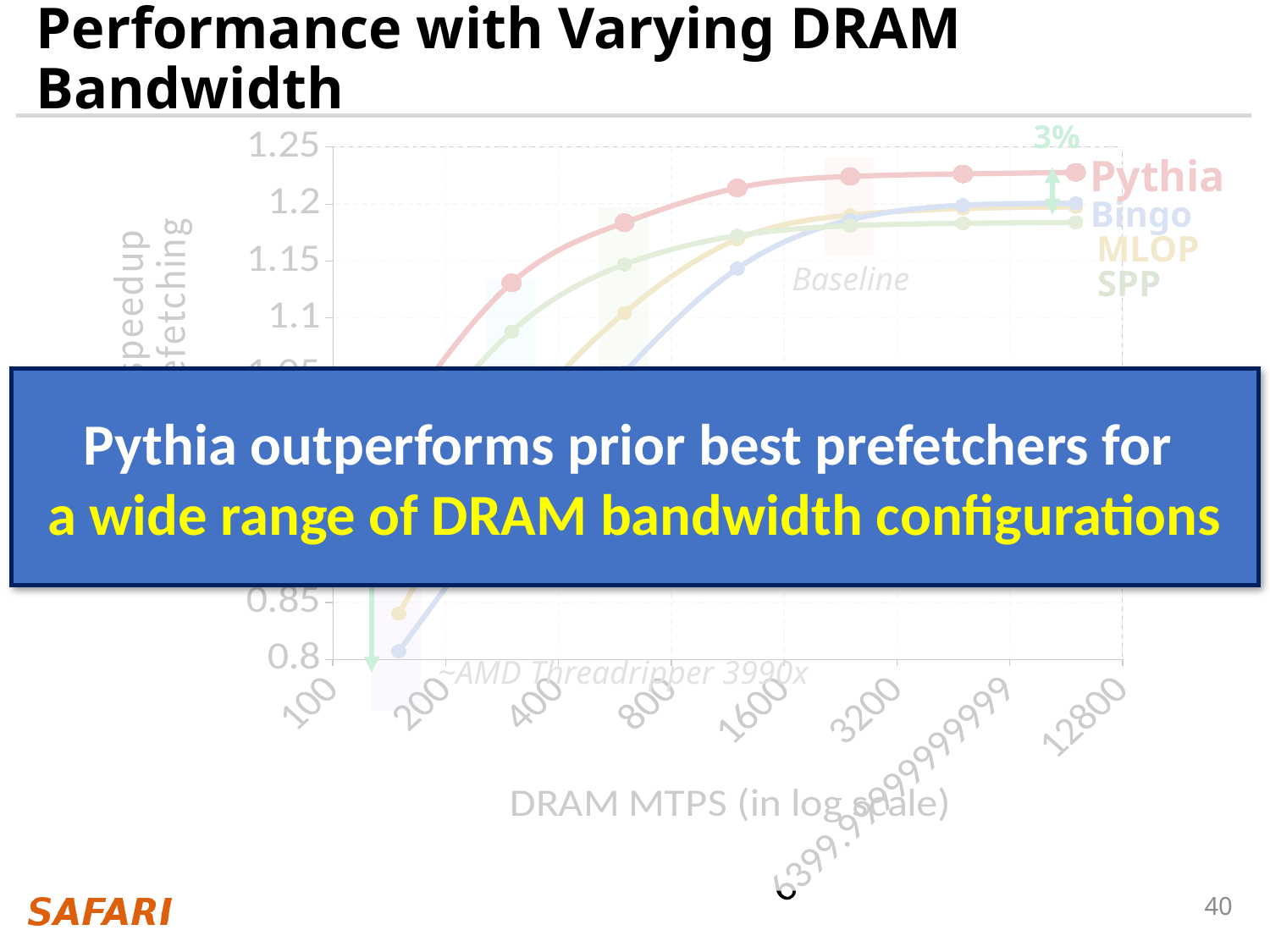
What is the label of the x axis? DRAM MTPS (in log scale) What kind of chart is shown on the slide? line chart What percentage improvement is annotated at the top right of the chart? 3% Do the speedup values rise or fall as DRAM MTPS increases along the x axis? rise How many tick labels are shown on the x axis? 8 How many series (prefetchers) are labelled on the chart? 4 What is the highest value shown on the y axis? 1.25 Is the lowest plotted Bingo value greater or less than 0.85? less Which series has the highest speedup at the rightmost point of the chart? Pythia At the rightmost point, which is larger: Pythia or Bingo? Pythia Is the rightmost SPP value greater or less than 1.2? less Is the rightmost Pythia value greater or less than 1.2? greater